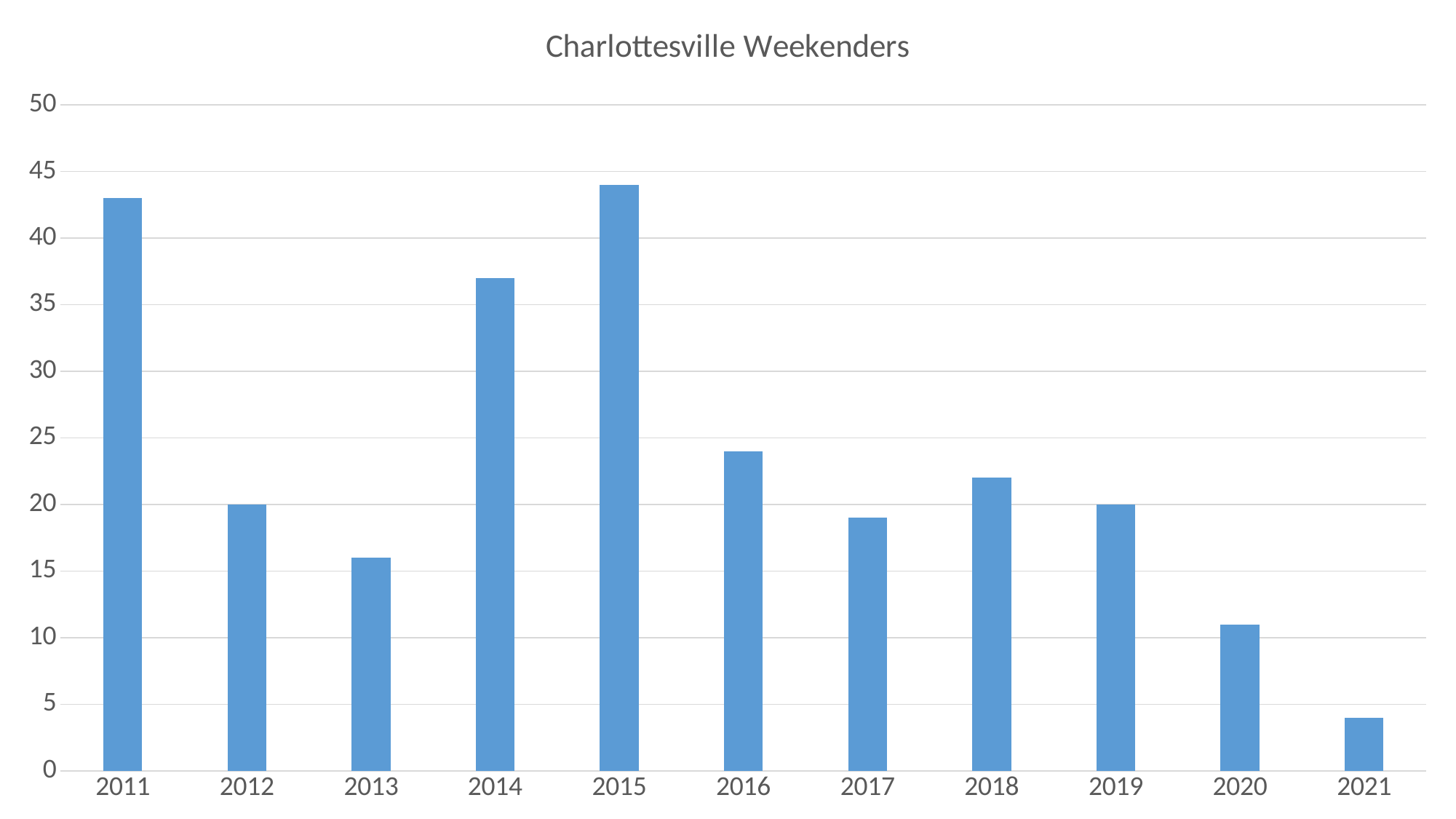
What is the title of the chart? Charlottesville Weekenders Which year has the lowest value? 2021 What kind of chart is shown on the slide? bar chart From 2018 to 2021, do the values rise or fall? fall What is the value for 2019? 20 Is the value for 2011 greater or less than 40? greater Is the value for 2021 greater or less than 5? less Is the value for 2013 greater or less than 20? less What is the value for 2012? 20 Which is larger, the value for 2014 or the value for 2016? 2014 How many years are shown on the x axis of the chart? 11